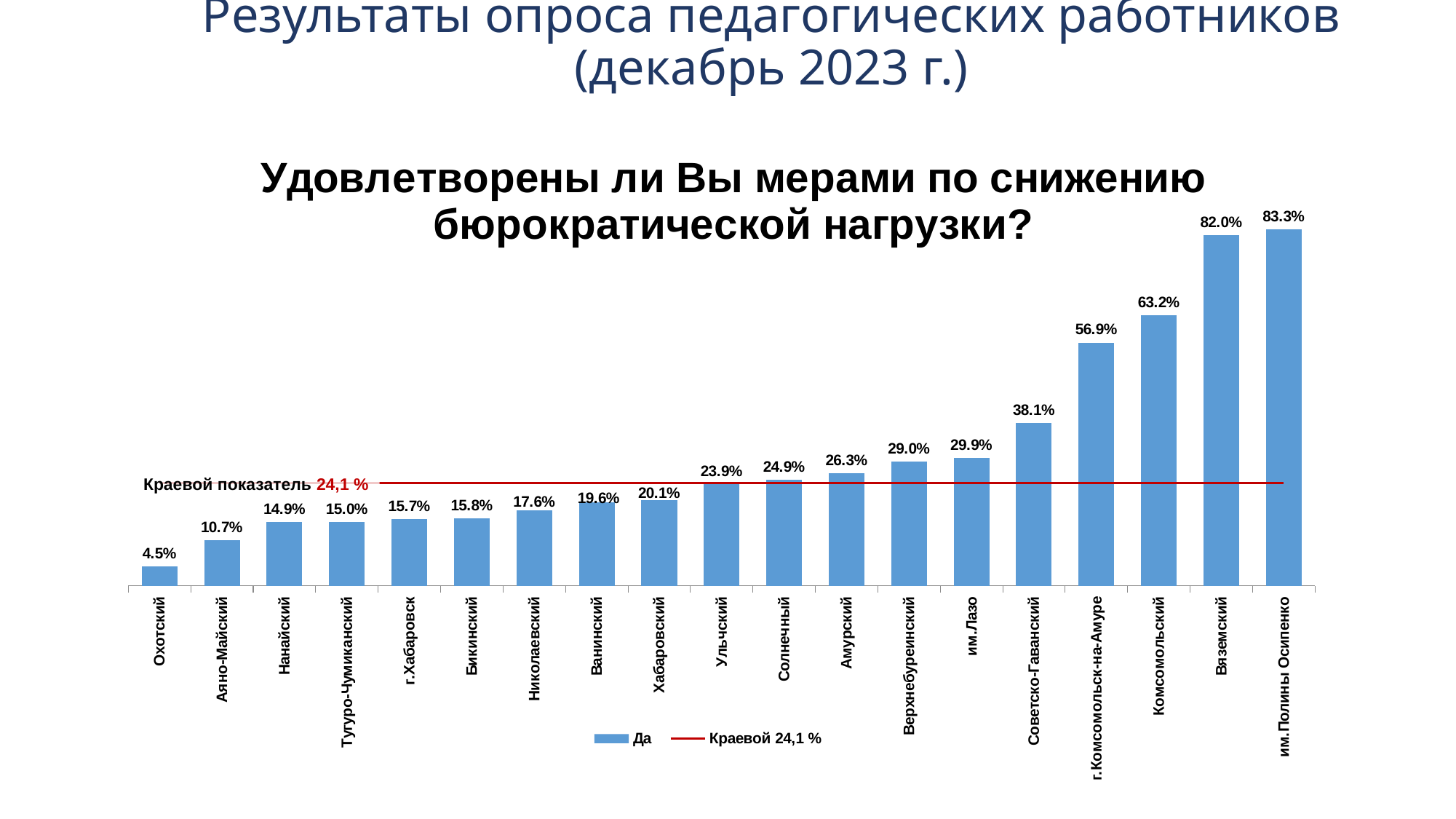
What is the difference between the values for Вяземский and Комсомольский? 18.8% Do the values rise or fall from left to right along the x axis? rise Which is larger, the value for Амурский or the value for Ульчский? Амурский What kind of chart is this? bar chart What is the value for г.Комсомольск-на-Амуре? 56.9% Which category has the lowest value? Охотский Which category has the highest value? им.Полины Осипенко What is the value for Охотский? 4.5% How many categories are shown on the x axis? 19 What value does the red horizontal line (Краевой показатель) represent? 24,1 % How many entries does the legend list? 2 What is the value for Советско-Гаванский? 38.1%